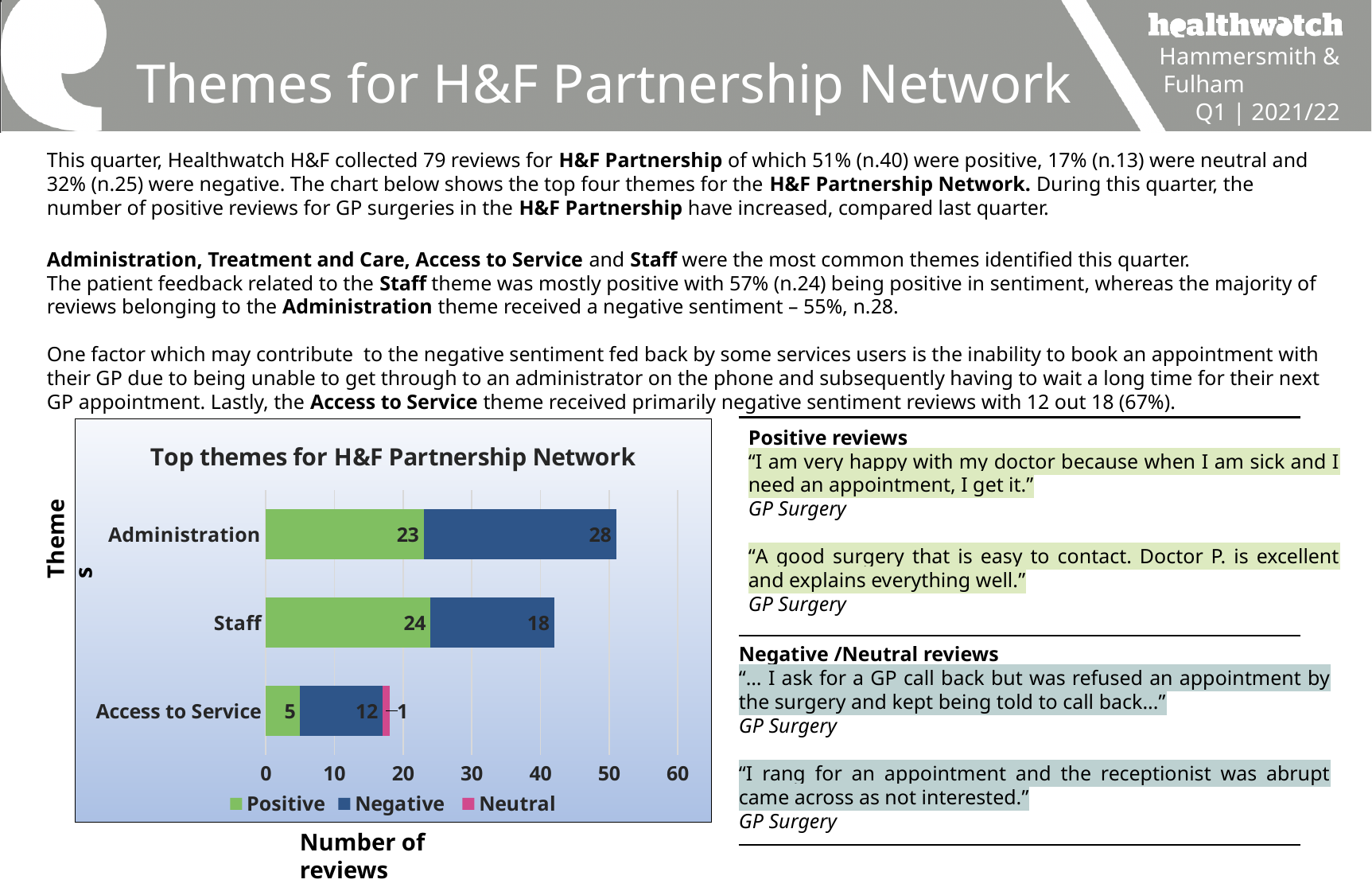
Which is larger for the Staff theme, the Positive or the Negative count? Positive What is the difference between the Negative and Positive reviews for the Administration theme? 5 Which theme has the lowest number of Positive reviews? Access to Service What is the total number of reviews shown in the Access to Service bar? 18 How many Negative reviews are shown for the Administration theme? 28 Which theme has the highest number of Negative reviews? Administration How many themes are plotted on the chart? 3 What is the title of the chart? Top themes for H&F Partnership Network What type of chart is shown on the slide? Stacked bar chart How many Positive reviews are shown for the Staff theme? 24 How many series does the chart legend list? 3 How many Neutral reviews are shown for the Access to Service theme? 1